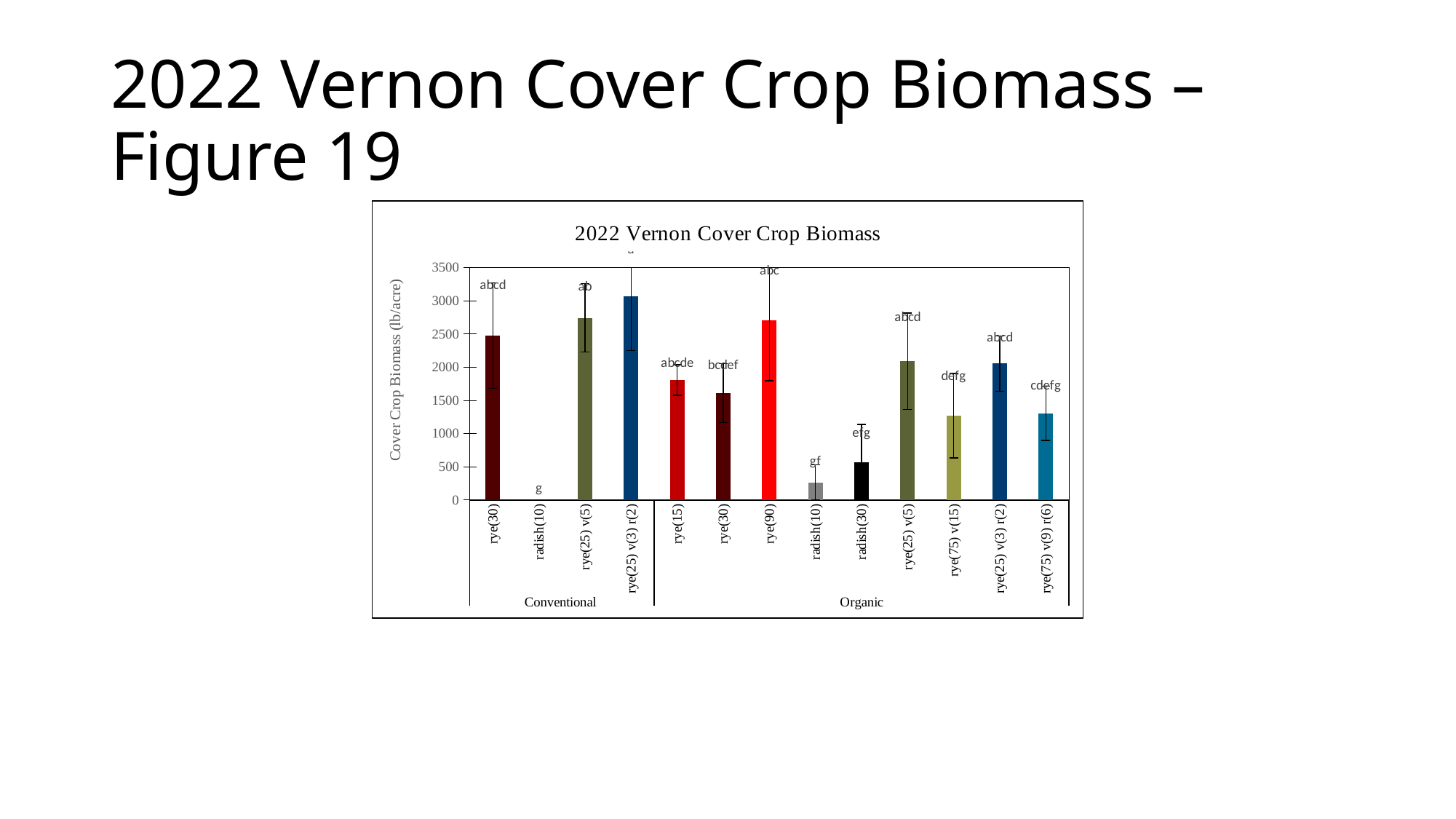
Which treatment has the highest cover crop biomass in the chart? rye(25) v(3) r(2) (Conventional) Which has the larger cover crop biomass: Conventional rye(25) v(5) or Organic rye(75) v(15)? Conventional rye(25) v(5) Which treatment has the lowest cover crop biomass in the chart? radish(10) (Conventional) What kind of chart is shown on the slide? Bar chart Which has the larger cover crop biomass: Organic rye(15) or Organic radish(30)? rye(15) Is the cover crop biomass for Organic radish(10) greater or less than 500? less How many bars (treatments) are plotted in the chart in total across both groups? 13 How many treatments are shown in the Organic group? 9 What is the title of the chart? 2022 Vernon Cover Crop Biomass Is the cover crop biomass for Organic rye(90) greater or less than 2500? greater What is the label of the vertical axis? Cover Crop Biomass (lb/acre)